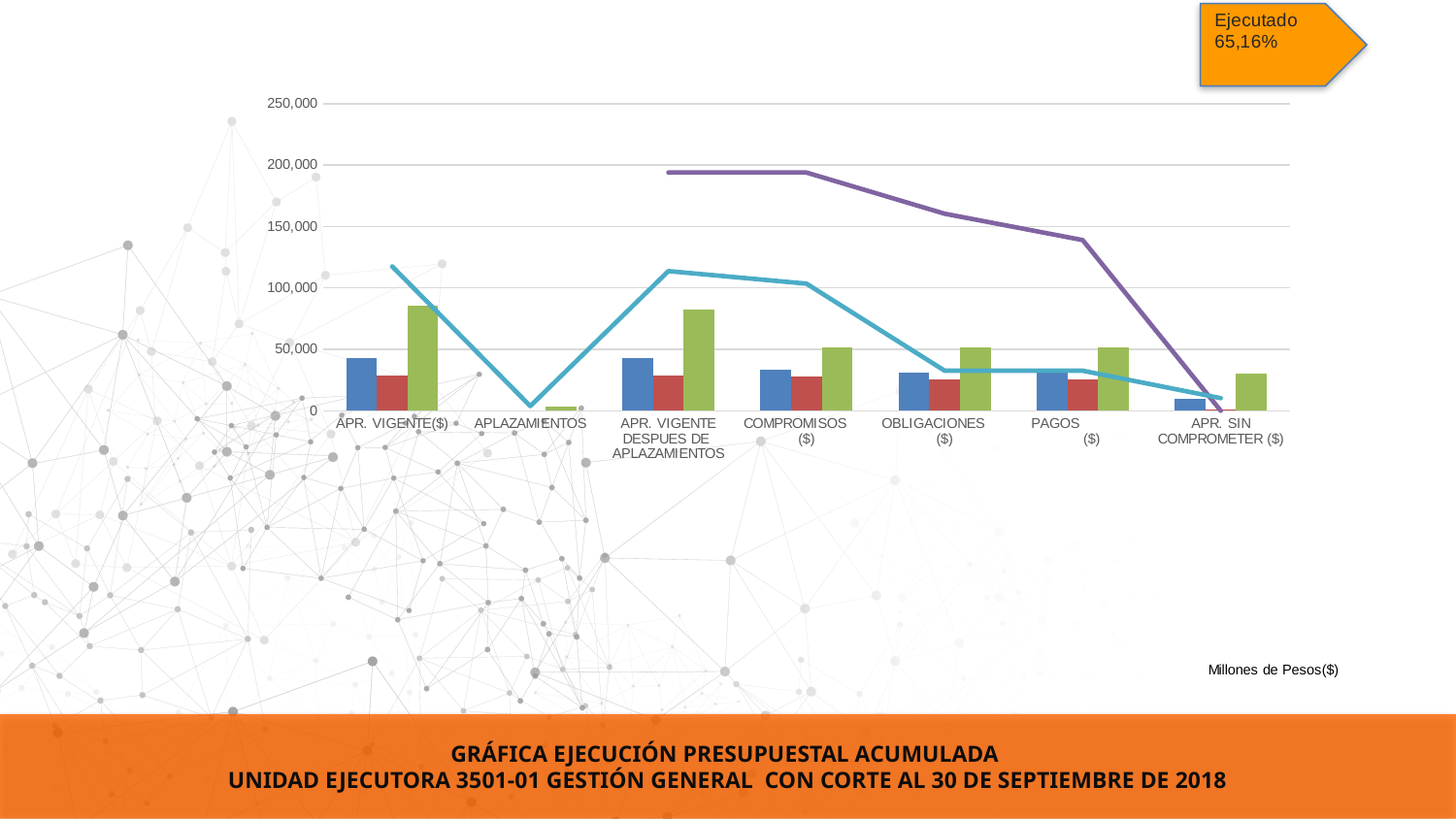
Which category has the lowest green bar? APLAZAMIENTOS Which is larger: the blue bar at APR. VIGENTE($) or the blue bar at APR. SIN COMPROMETER ($)? APR. VIGENTE($) What kind of chart is shown on the slide? Combined bar and line chart Is the value of the teal line at OBLIGACIONES ($) greater or less than 50,000? less Is the value of the purple line at APR. VIGENTE DESPUES DE APLAZAMIENTOS greater or less than 150,000? greater Is the value of the teal line at APLAZAMIENTOS greater or less than 50,000? less How many categories are shown on the x axis of the chart? 7 Does the purple line rise or fall from APR. VIGENTE DESPUES DE APLAZAMIENTOS to APR. SIN COMPROMETER ($)? fall What unit is indicated for the chart values in the note at the bottom right of the chart? Millones de Pesos($)